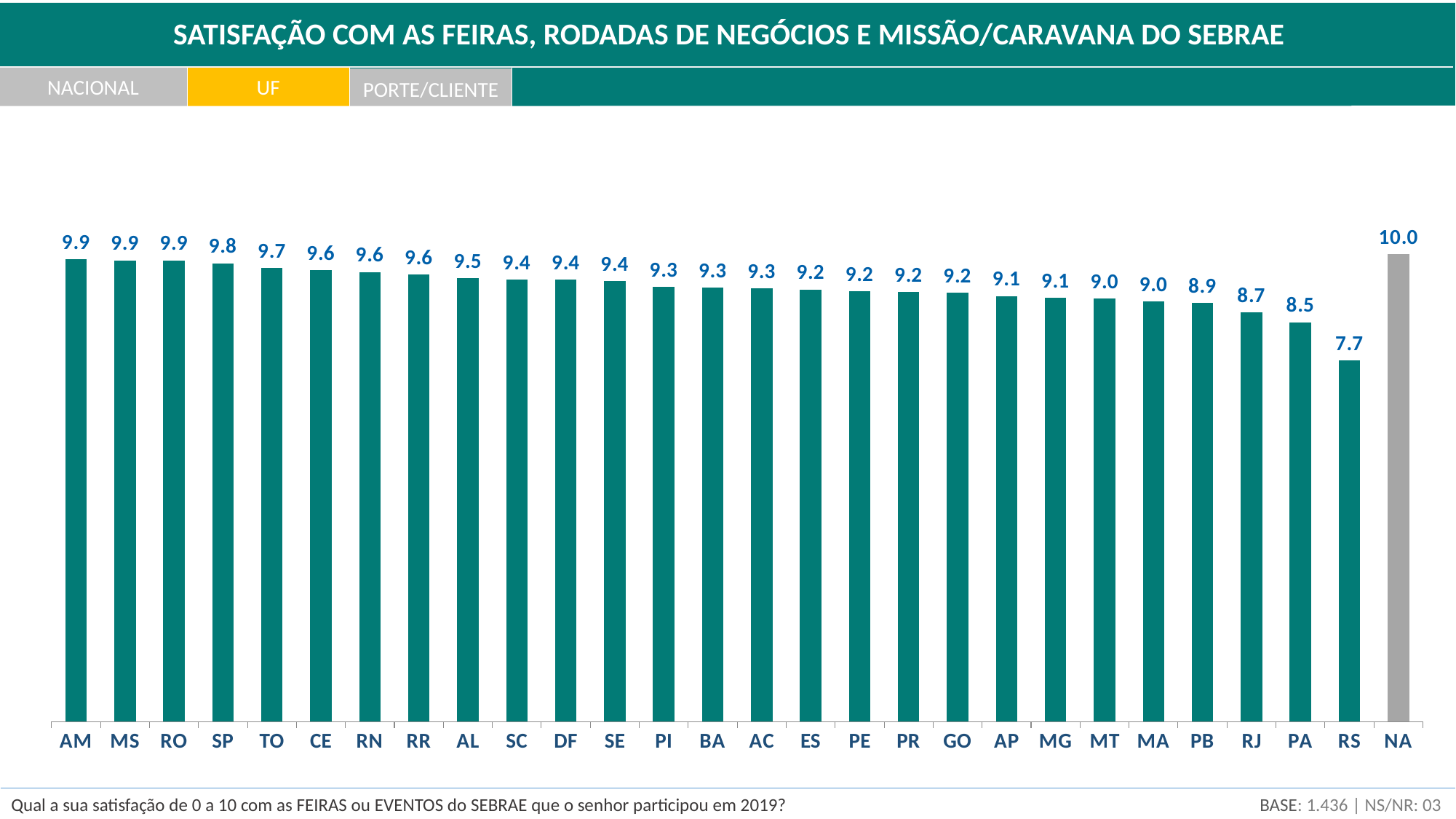
Which bar is shown in grey rather than teal? NA What is the value for RS? 7.7 Which is larger, the value for TO or the value for RJ? TO What is the value for NA? 10.0 What is the value for SP? 9.8 Which category has the lowest value? RS What is the difference between the values for NA and PA? 1.5 What is the value for PB? 8.9 What is the difference between the values for AM and RS? 2.2 Which category has the highest value? NA What kind of chart is this? Bar chart How many categories are shown on the x axis? 28